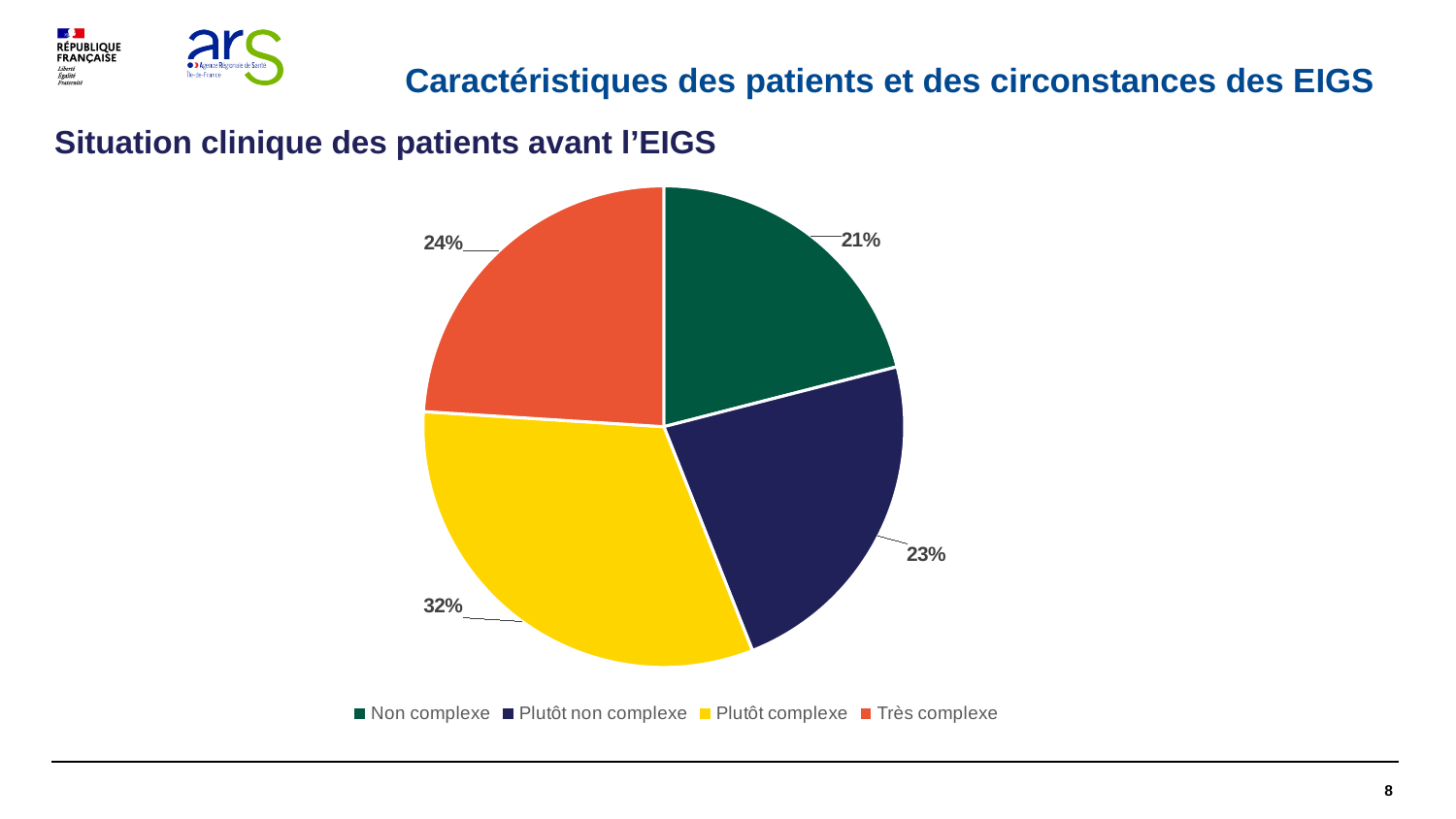
How many slices does the pie chart have? 4 What colour is the "Plutôt complexe" slice? yellow What is the difference in percentage points between "Plutôt complexe" and "Non complexe"? 11 What kind of chart is shown on the slide? pie chart What share of the pie is labelled "Plutôt non complexe"? 23% Which category has the smallest slice of the pie? Non complexe What share of the pie is labelled "Plutôt complexe"? 32% What share of the pie is labelled "Non complexe"? 21% How many entries does the legend list? 4 Which is larger, the share for "Très complexe" or the share for "Non complexe"? Très complexe What share of the pie is labelled "Très complexe"? 24% Which category has the largest slice of the pie? Plutôt complexe